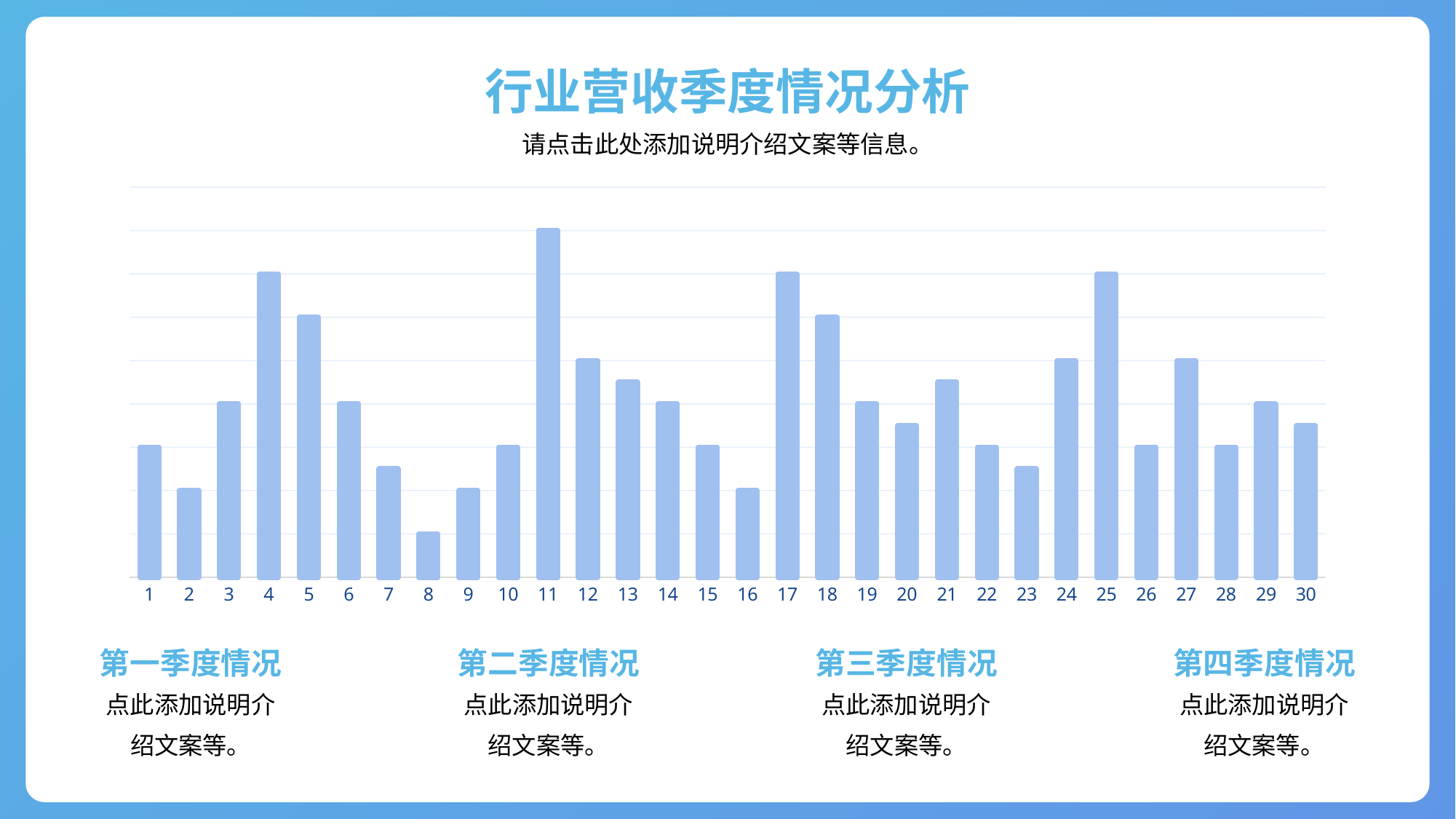
Which has the larger value, category 11 or category 12? 11 Which has the larger value, category 26 or category 27? 27 Which category has the lowest bar in the chart? 8 Which category has the highest bar in the chart? 11 Which has the larger value, category 8 or category 9? 9 What is the title of the slide above the chart? 行业营收季度情况分析 What kind of chart is shown on the slide? bar chart How many categories are plotted along the x axis of the chart? 30 What colour are the bars in the chart? light blue